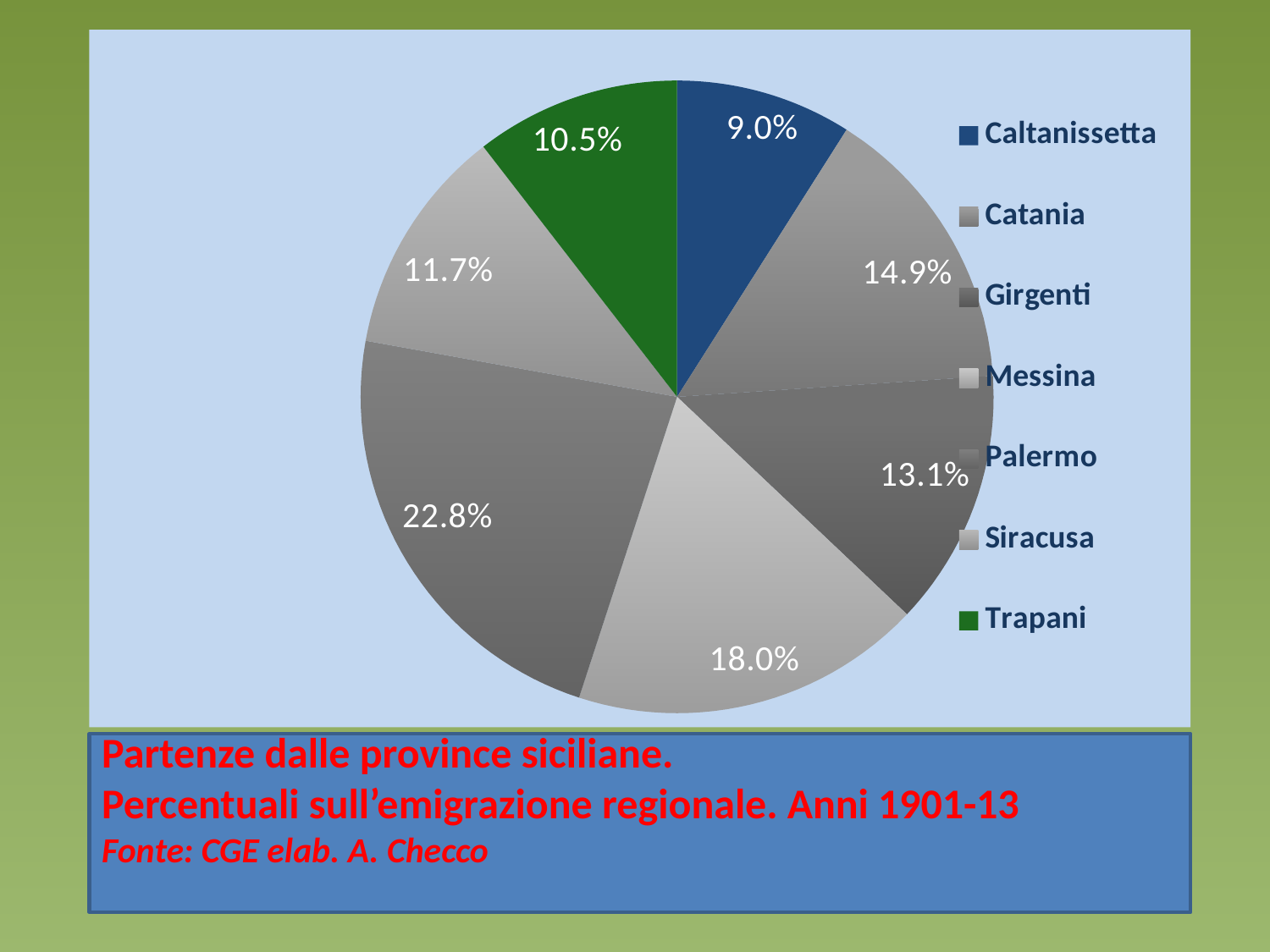
What share is shown for Trapani? 10.5% Which is larger, the slice for Catania or the slice for Girgenti? Catania What percentage of the pie does Palermo account for? 22.8% What is the combined share of Siracusa and Trapani? 22.2% What type of chart is shown on the slide? Pie chart What is the value shown for Caltanissetta? 9.0% Which province has the largest slice of the pie? Palermo How many provinces are shown in the pie chart? 7 What is the value shown for Messina? 18.0% Which province's slice is coloured green? Trapani Which province has the smallest slice of the pie? Caltanissetta What is the difference between the Palermo and Messina percentages? 4.8%